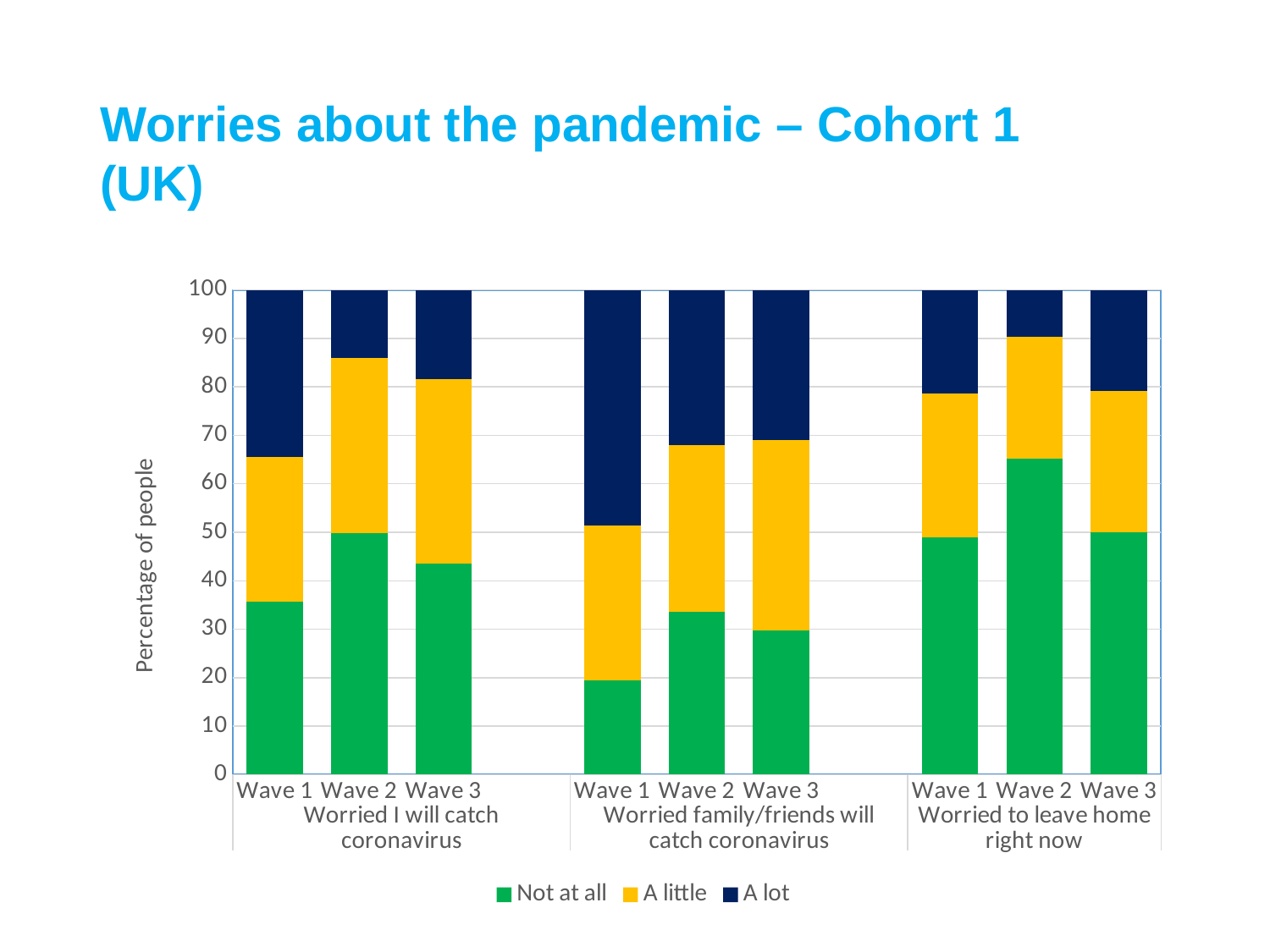
Is the 'Not at all' value for Wave 2 under 'Worried to leave home right now' greater or less than 60? greater Which bar has the largest 'A lot' segment? Wave 1, Worried family/friends will catch coronavirus How many bars are plotted in the chart? 9 Is the 'Not at all' value for Wave 1 under 'Worried I will catch coronavirus' greater or less than 40? less Is the 'Not at all' value for Wave 1 under 'Worried family/friends will catch coronavirus' greater or less than 30? less What is the title of the vertical axis? Percentage of people Which bar has the largest 'Not at all' segment? Wave 2, Worried to leave home right now How many series does the legend list? 3 Which is larger: the 'Not at all' value for Wave 1 under 'Worried I will catch coronavirus' or for Wave 1 under 'Worried family/friends will catch coronavirus'? Wave 1, Worried I will catch coronavirus Which colour represents 'A lot' in the legend? Dark blue Which bar has the smallest 'Not at all' segment? Wave 1, Worried family/friends will catch coronavirus What kind of chart is shown on the slide? Stacked bar chart